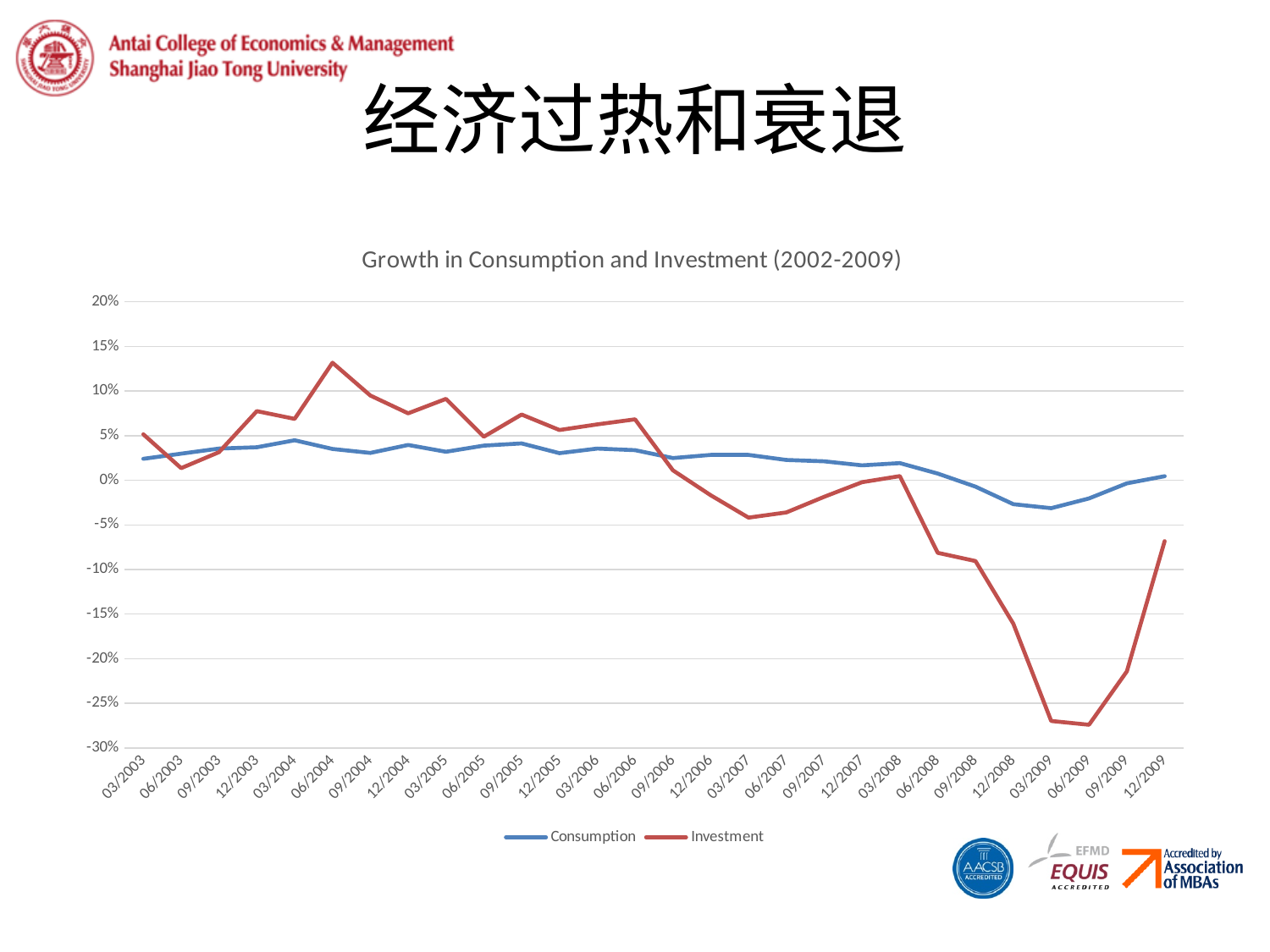
What is the title of the chart? Growth in Consumption and Investment (2002-2009) Is the value for Investment at 03/2009 greater or less than -25%? less Which series reaches the lowest value on the chart? Investment Does the Investment series rise or fall from 06/2009 to 12/2009? rise Is the value for Consumption at 12/2008 greater or less than 0%? less At which date does the Investment series reach its highest value? 06/2004 What kind of chart is shown on the slide? line chart How many quarterly points are shown along the x axis? 28 Which two series are listed in the legend? Consumption and Investment Is the value for Investment at 06/2004 greater or less than 10%? greater How many series does the legend list? 2 At 03/2007, which series has the larger value, Consumption or Investment? Consumption